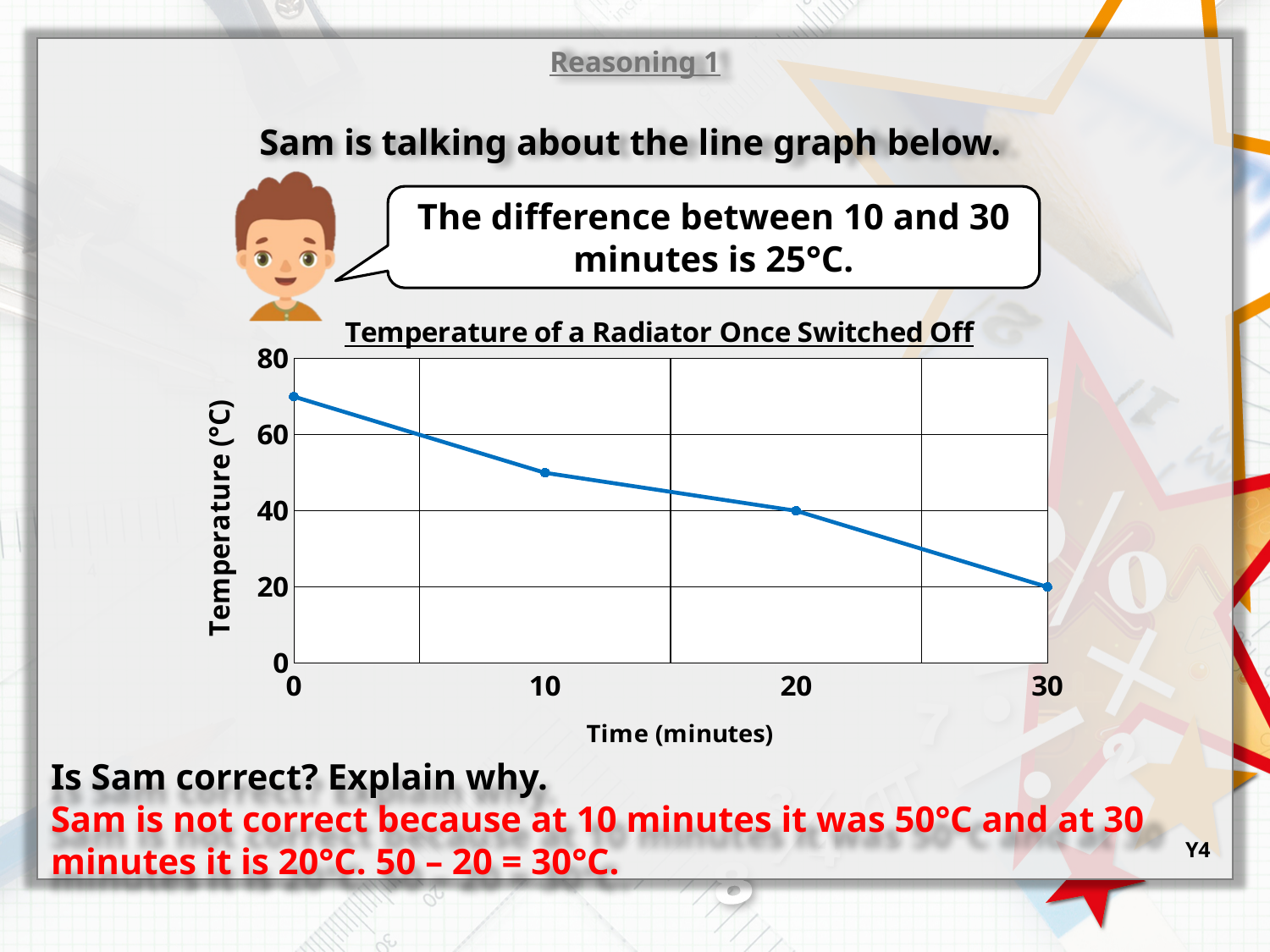
At which time is the temperature lowest? 30 minutes How many data points are plotted on the line? 4 What kind of chart is shown on the slide? Line chart What is the temperature at 10 minutes? 50°C At which time is the temperature highest? 0 minutes Which has the higher temperature, 10 minutes or 20 minutes? 10 minutes What is the temperature at 20 minutes? 40°C What is the difference in temperature between 10 minutes and 30 minutes? 30°C Is the temperature at 0 minutes greater or less than 60? greater What is the title of the chart? Temperature of a Radiator Once Switched Off What is the temperature at 30 minutes? 20°C Does the temperature rise or fall as time increases? Fall